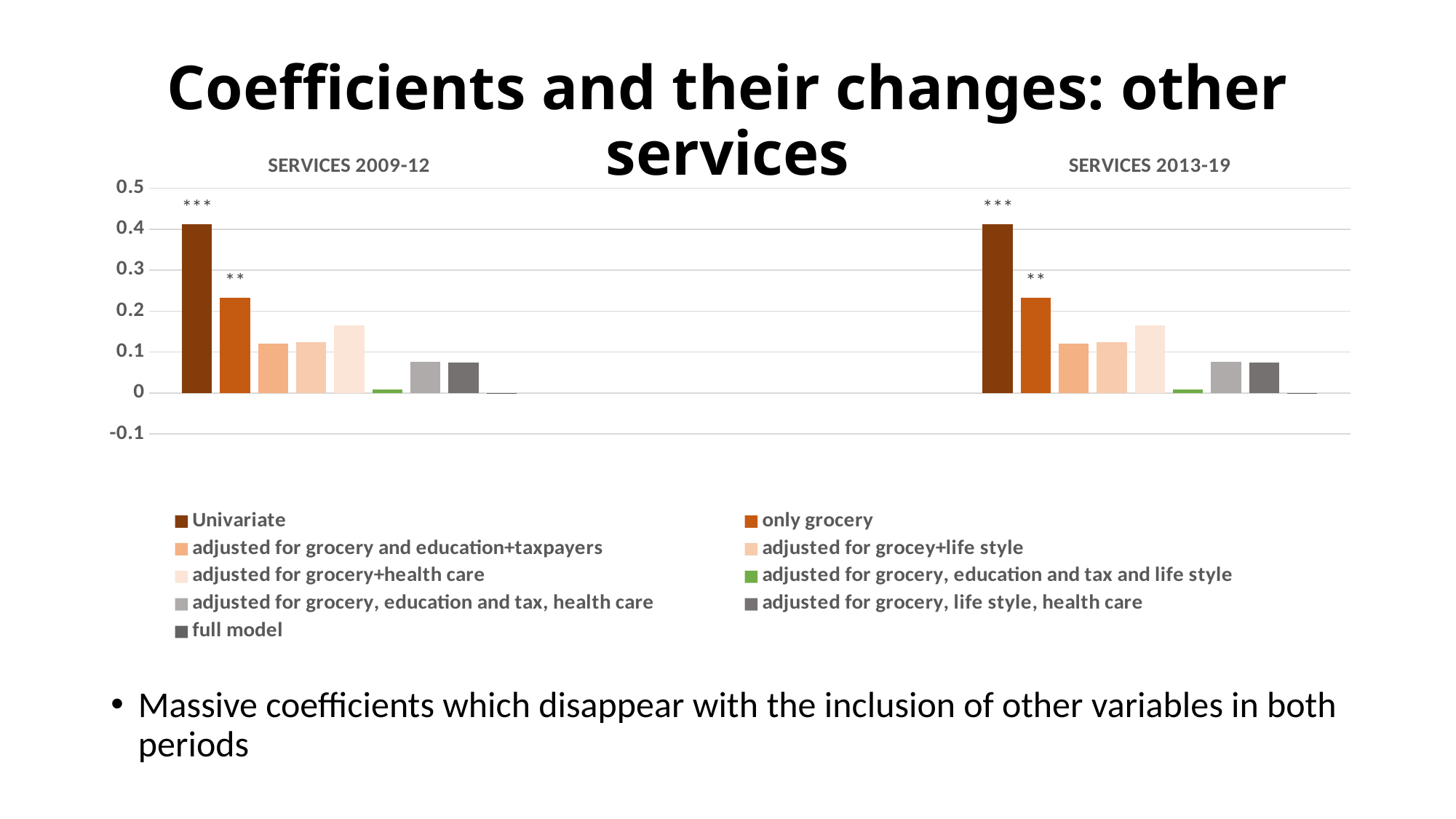
Is the value for adjusted for grocery, education and tax, health care in the SERVICES 2013-19 group greater or less than 0.1? less What kind of chart is shown on the slide? bar chart Is the value for only grocery in the SERVICES 2013-19 group greater or less than 0.3? less How many series does the legend list? 9 Is the value for Univariate in the SERVICES 2009-12 group greater or less than 0.4? greater In the SERVICES 2009-12 group, which is larger: Univariate or only grocery? Univariate In the SERVICES 2013-19 group, which is larger: adjusted for grocery+health care or adjusted for grocery, education and tax and life style? adjusted for grocery+health care How many category groups are plotted on the x axis? 2 What are the labels of the two category groups on the x axis? SERVICES 2009-12 and SERVICES 2013-19 Which series has the highest value in the SERVICES 2009-12 group? Univariate Which series has the highest value in the SERVICES 2013-19 group? Univariate